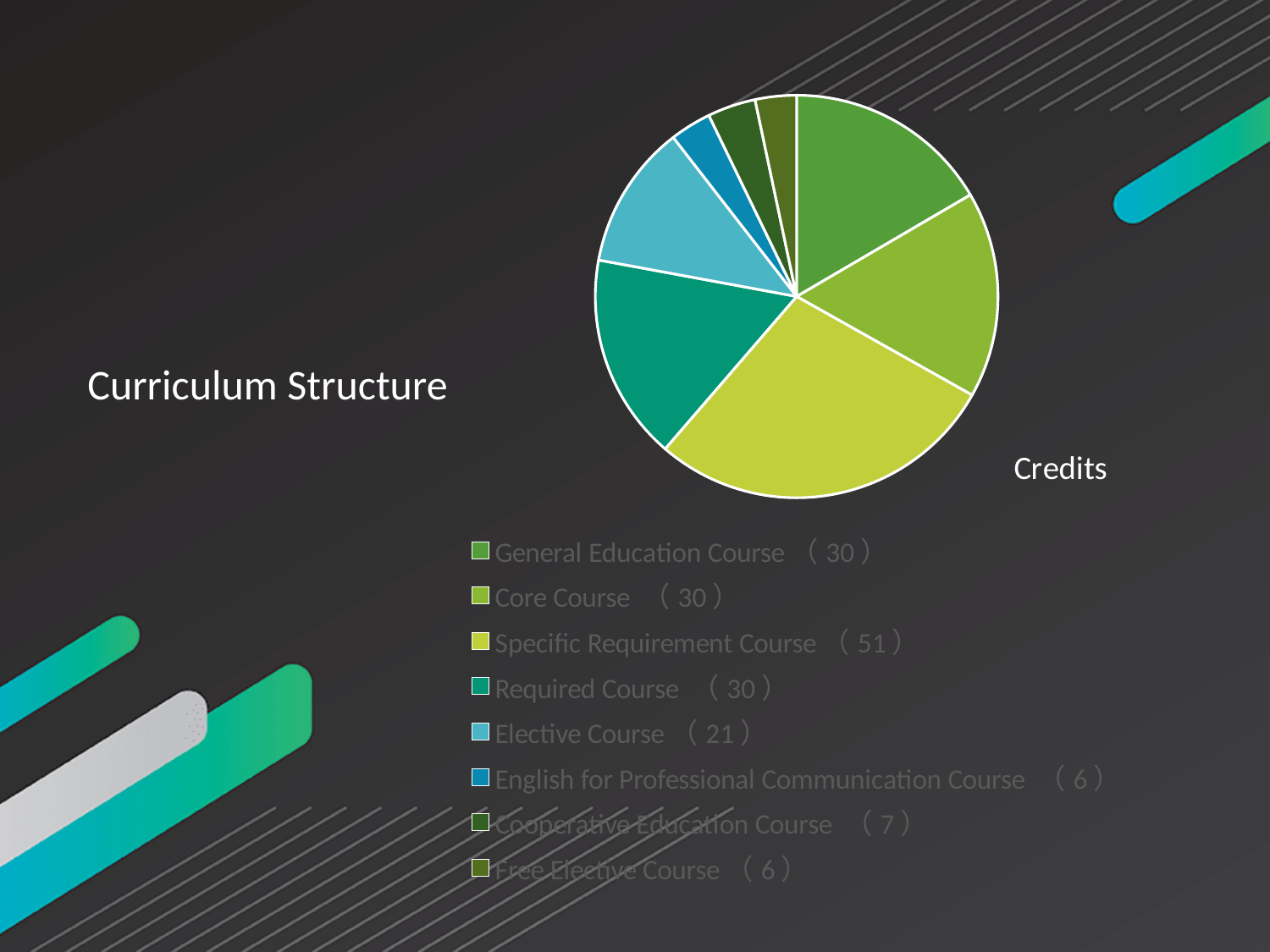
Which categories have the fewest credits? English for Professional Communication Course and Free Elective Course How many credits does the Elective Course have? 21 What is the difference in credits between the Specific Requirement Course and the Required Course? 21 How many credits does the Cooperative Education Course have? 7 Which has more credits, the Cooperative Education Course or the Free Elective Course? Cooperative Education Course What is the title of the chart? Credits What kind of chart is shown on the slide? pie chart How many credits does the Specific Requirement Course have? 51 What is the total number of credits across all categories in the pie chart? 181 Which category has the largest number of credits? Specific Requirement Course How many categories does the pie chart have? 8 What is the difference in credits between the Elective Course and the English for Professional Communication Course? 15